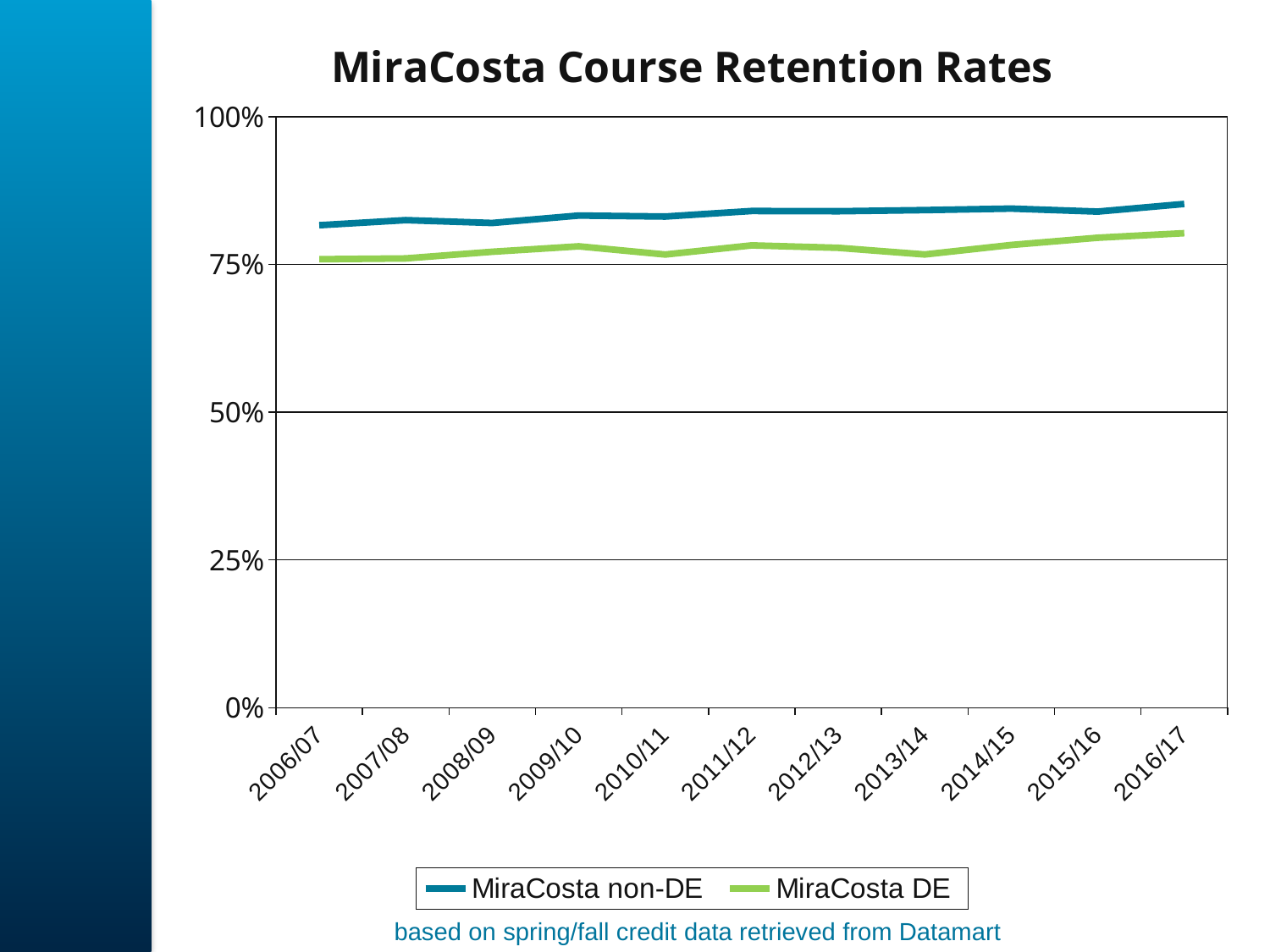
How many series does the legend list? 2 What kind of chart is shown on the slide? line chart Is the MiraCosta non-DE retention rate for 2016/17 greater or less than 100%? less What are the two series named in the legend? MiraCosta non-DE and MiraCosta DE Which series has the higher retention rate in 2006/07, MiraCosta non-DE or MiraCosta DE? MiraCosta non-DE Is the MiraCosta non-DE retention rate for 2006/07 greater or less than 75%? greater Which series has the higher retention rate in 2016/17, MiraCosta non-DE or MiraCosta DE? MiraCosta non-DE How many academic years are plotted along the x axis? 11 In which year is the MiraCosta DE retention rate highest? 2016/17 Is the MiraCosta DE retention rate for 2016/17 greater or less than 75%? greater What is the title of the chart? MiraCosta Course Retention Rates Does the MiraCosta DE retention rate generally rise or fall from 2006/07 to 2016/17? rise